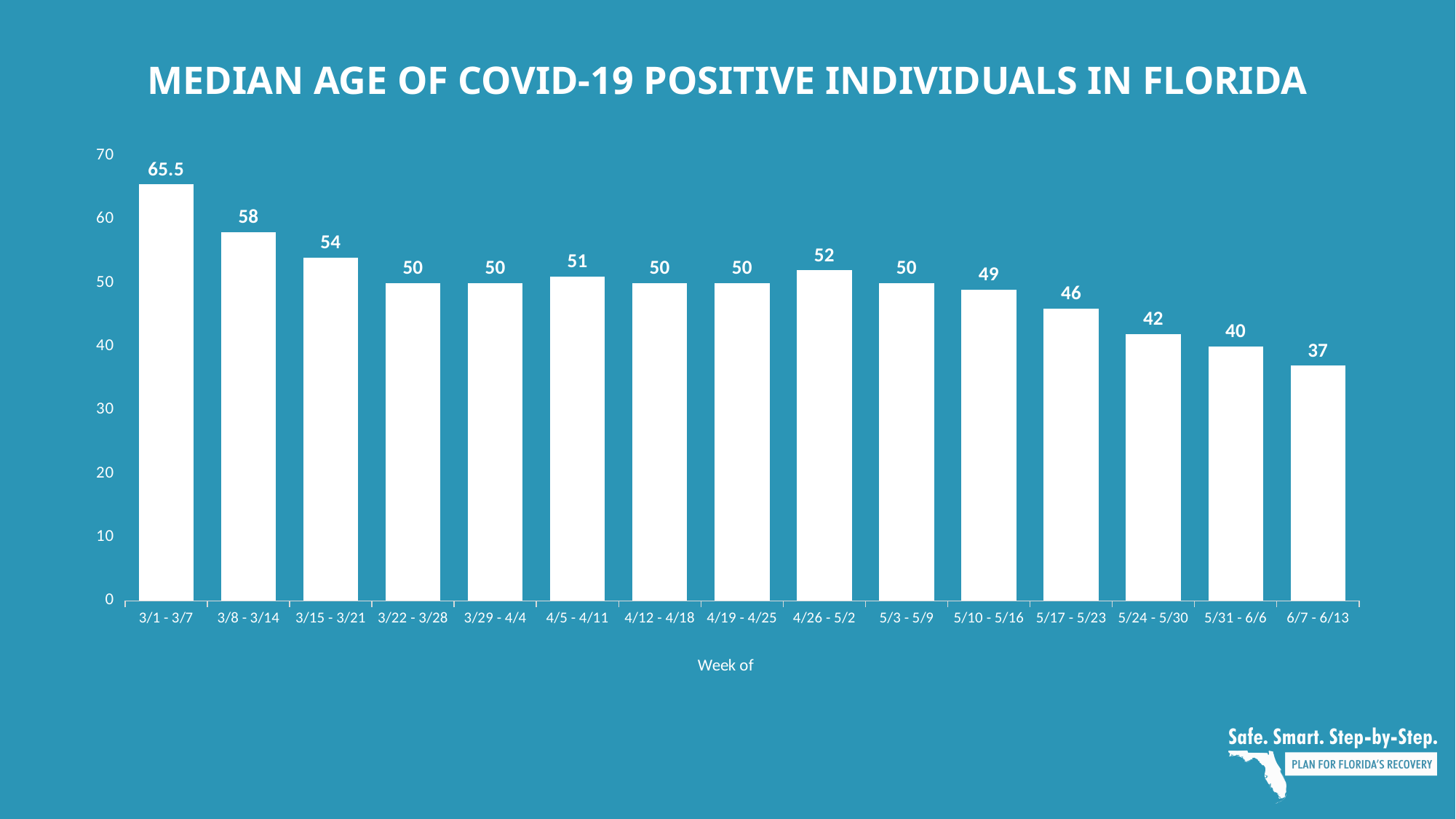
Is the median age for the week of 3/15 - 3/21 greater or less than 50? greater What is the median age for the week of 4/26 - 5/2? 52 Which week has the lowest median age? 6/7 - 6/13 Which week has a higher median age, 5/17 - 5/23 or 5/31 - 6/6? 5/17 - 5/23 What is the difference between the median age for 3/8 - 3/14 and 5/24 - 5/30? 16 How many weeks are shown on the x axis? 15 What is the median age for the week of 6/7 - 6/13? 37 Which week has the highest median age? 3/1 - 3/7 What is the median age for the week of 3/1 - 3/7? 65.5 Do the median ages generally rise or fall from the week of 3/1 - 3/7 to the week of 6/7 - 6/13? Fall What kind of chart is shown on the slide? Bar chart What is the difference between the median age for 3/1 - 3/7 and 6/7 - 6/13? 28.5